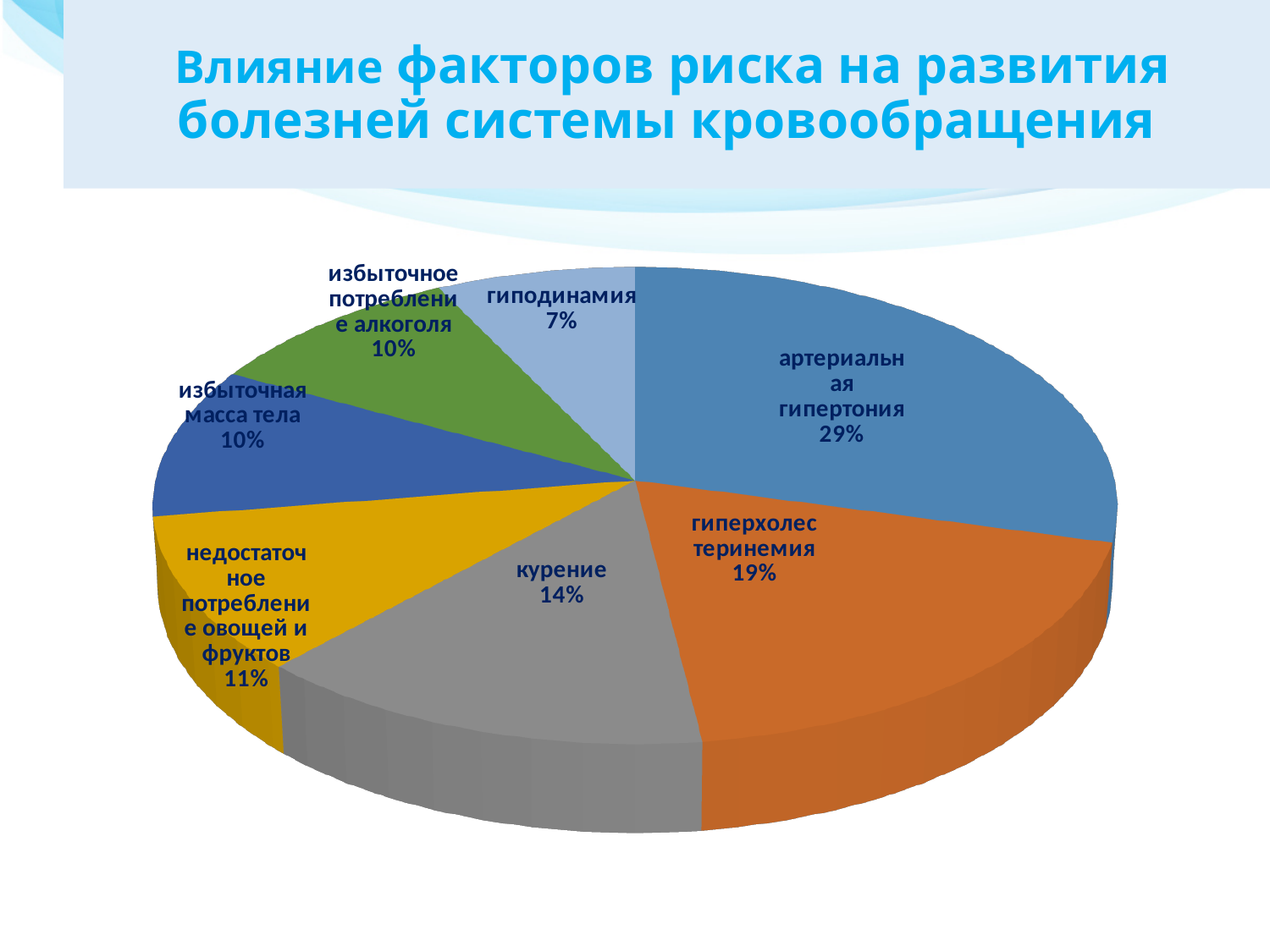
What is the difference in percentage points between артериальная гипертония and гиперхолестеринемия? 10 How many slices does the pie chart have? 7 What is the value shown for гиподинамия? 7% What kind of chart is shown on the slide? pie chart What share of the pie does артериальная гипертония account for? 29% Which is larger, the slice for курение or the slice for избыточная масса тела? курение What is the value shown for недостаточное потребление овощей и фруктов? 11% What is the title of the slide? Влияние факторов риска на развития болезней системы кровообращения Which risk factor has the smallest slice of the pie? гиподинамия Which risk factor has the largest slice of the pie? артериальная гипертония What is the value shown for курение? 14% What is the value shown for гиперхолестеринемия? 19%